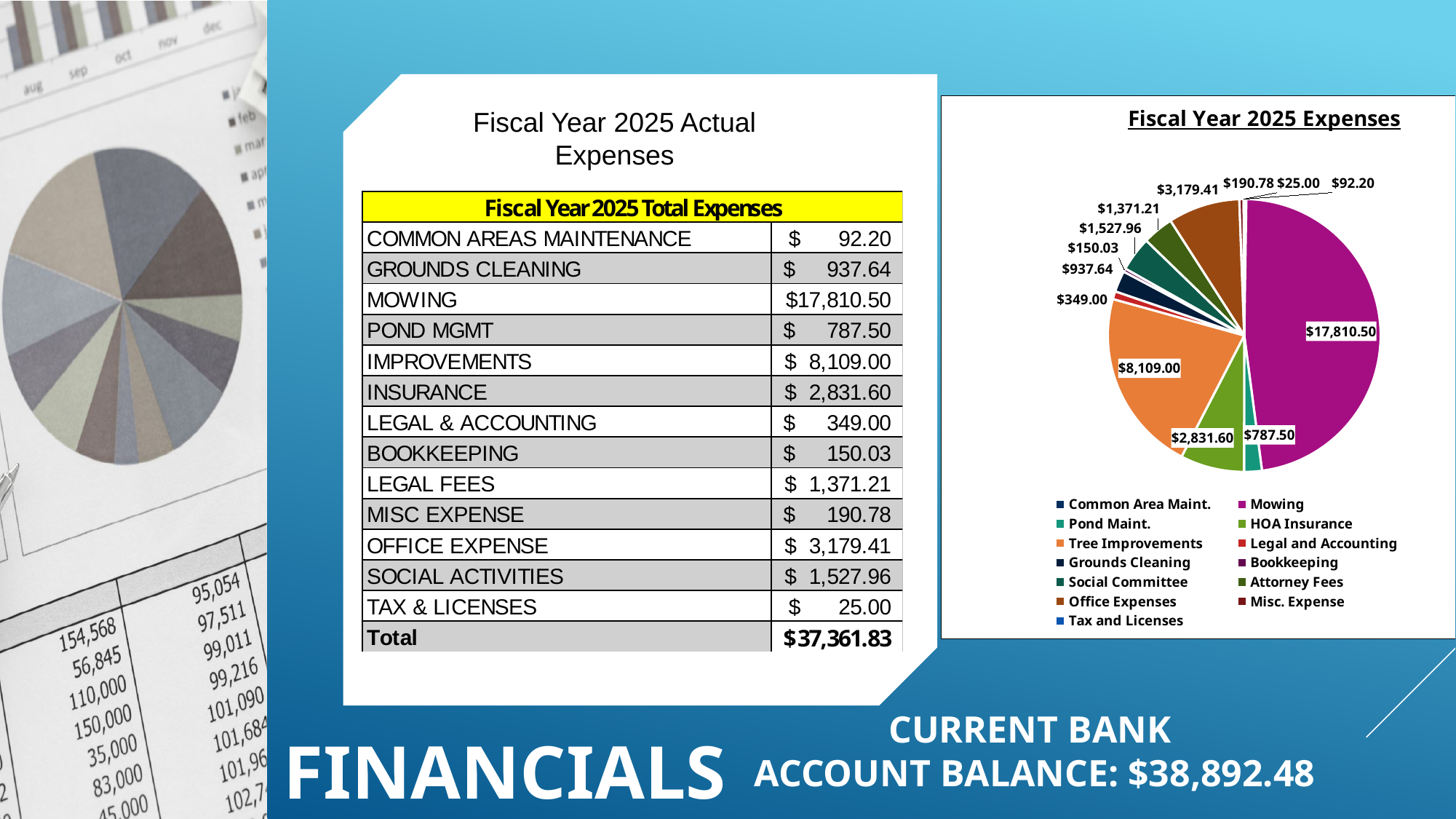
In the "Fiscal Year 2025 Expenses" pie chart, what is the value of the Tree Improvements slice? $8,109.00 In the "Fiscal Year 2025 Expenses" pie chart, what is the value of the Office Expenses slice? $3,179.41 How many categories does the legend of the "Fiscal Year 2025 Expenses" pie chart list? 13 In the "Fiscal Year 2025 Expenses" pie chart, what is the value of the HOA Insurance slice? $2,831.60 Which category has the smallest slice in the "Fiscal Year 2025 Expenses" pie chart? Tax and Licenses Which category has the largest slice in the "Fiscal Year 2025 Expenses" pie chart? Mowing What kind of chart is the "Fiscal Year 2025 Expenses" chart? pie chart In the "Fiscal Year 2025 Expenses" pie chart, what is the value of the Mowing slice? $17,810.50 What colour is the Mowing slice in the "Fiscal Year 2025 Expenses" pie chart? magenta What share of the total expenses ($37,361.83) does the Mowing slice represent in the "Fiscal Year 2025 Expenses" pie chart, to one decimal place? 47.7% In the "Fiscal Year 2025 Expenses" pie chart, which is larger: Office Expenses or HOA Insurance? Office Expenses In the "Fiscal Year 2025 Expenses" pie chart, how much larger is the Mowing slice than the Tree Improvements slice? $9,701.50